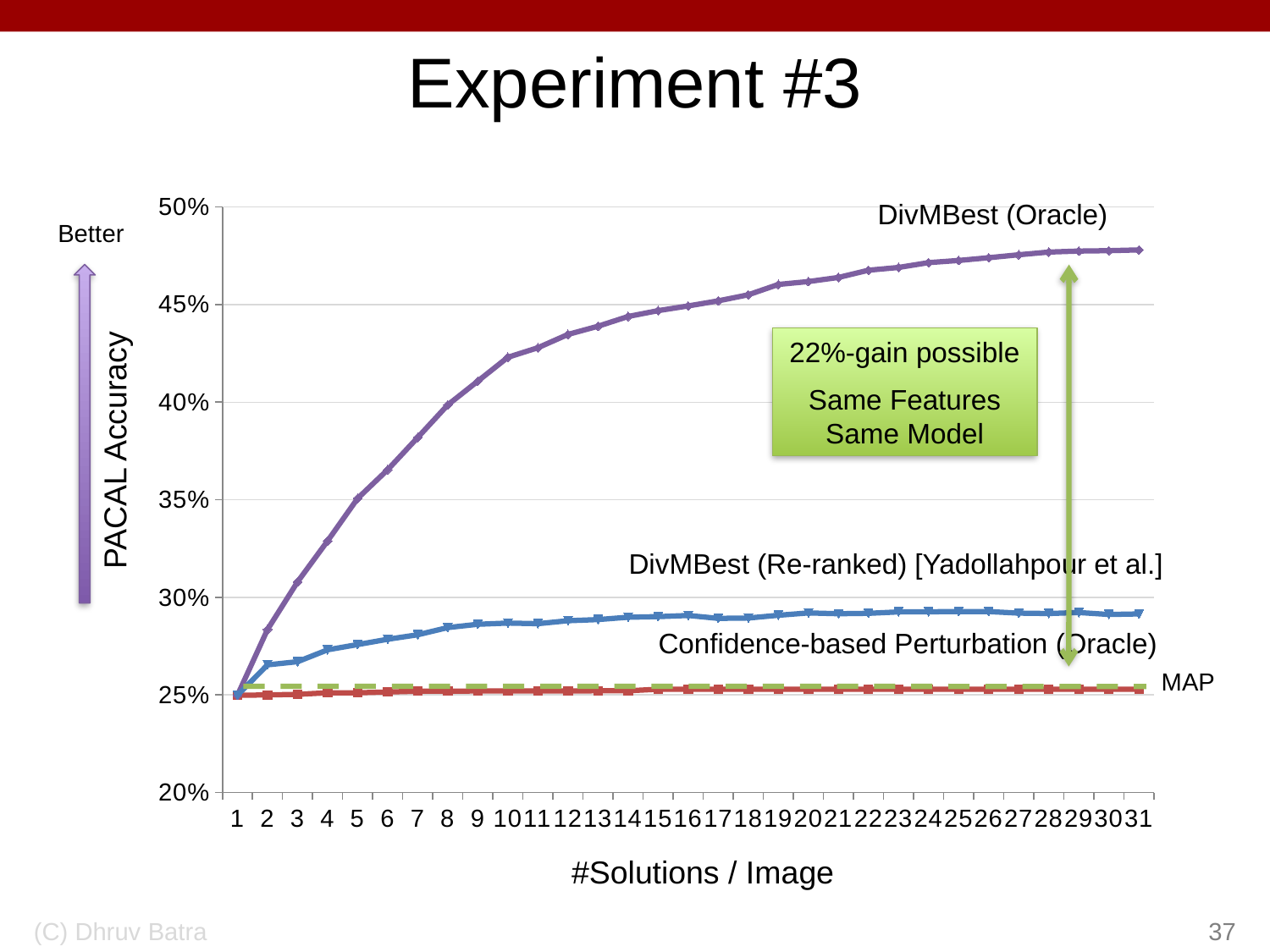
How many series are plotted on the chart? 3 Is the PACAL Accuracy of DivMBest (Oracle) at 5 solutions per image greater or less than 40%? less Is the PACAL Accuracy of DivMBest (Oracle) at 31 solutions per image greater or less than 45%? greater Which series has the lowest PACAL Accuracy at 31 solutions per image? Confidence-based Perturbation (Oracle) What is the label of the y axis? PACAL Accuracy Is the PACAL Accuracy of DivMBest (Re-ranked) at 31 solutions per image greater or less than 30%? less How many points along the x axis (#Solutions / Image) does the chart cover? 31 What kind of chart is shown on the slide? line chart Does the DivMBest (Oracle) series rise or fall as the number of solutions per image increases? rises What is the label of the x axis? #Solutions / Image Which is higher at 20 solutions per image: DivMBest (Oracle) or DivMBest (Re-ranked)? DivMBest (Oracle) Which series reaches the highest PACAL Accuracy at 31 solutions per image? DivMBest (Oracle)